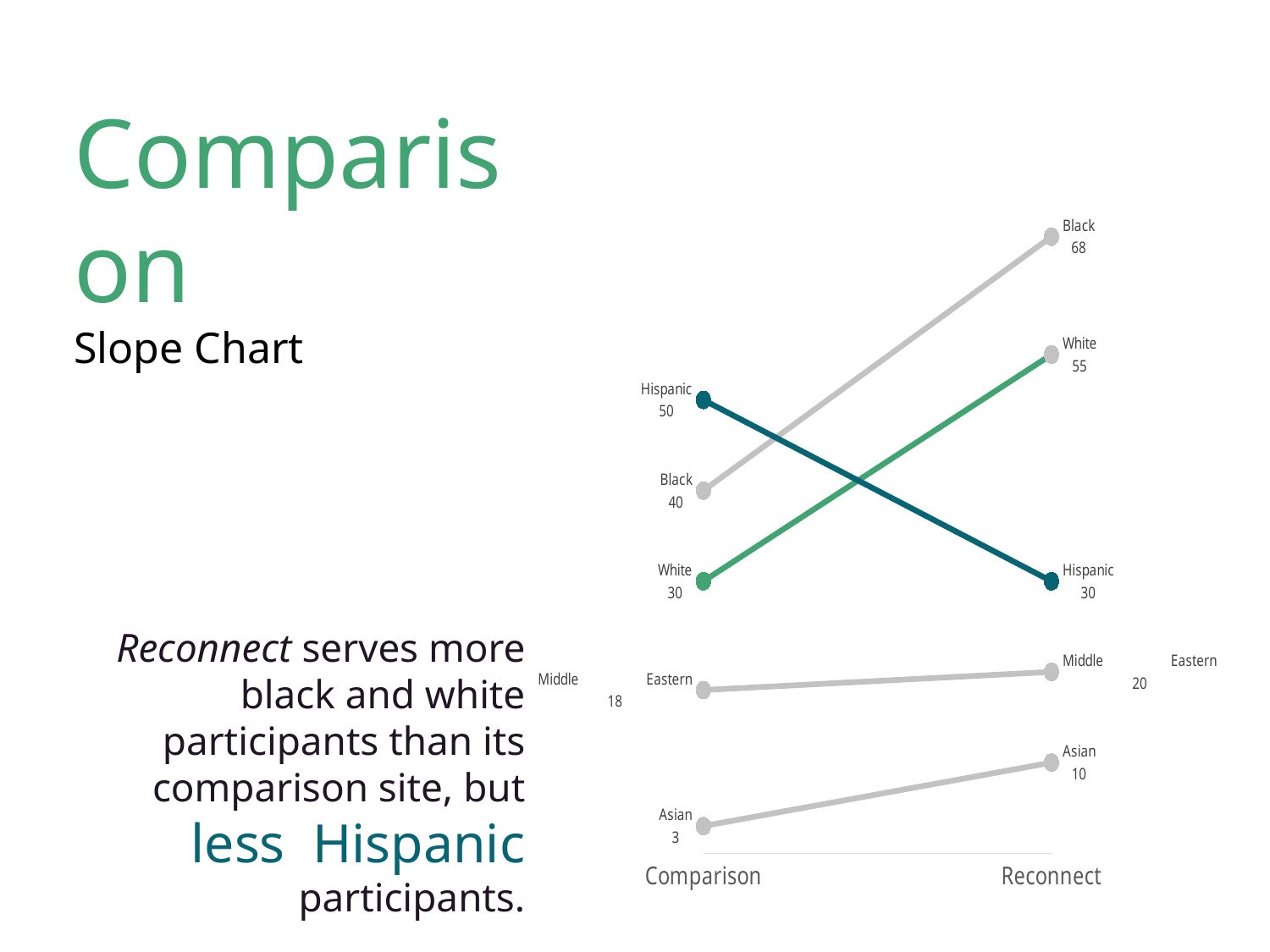
By how much does the Black value increase from Comparison to Reconnect? 28 Which group has the lowest value at the Comparison site? Asian What is the value for Black at the Reconnect site? 68 What is the value for Asian at the Comparison site? 3 What type of chart is shown on the slide? Slope chart What is the difference between the Hispanic values at Comparison and Reconnect? 20 What is the value for Hispanic at the Comparison site? 50 How many groups are plotted on the slope chart? 5 Which is larger: the White value at Reconnect or the Hispanic value at Comparison? White value at Reconnect Does the Hispanic value rise or fall from Comparison to Reconnect? Fall Which group has the highest value at the Reconnect site? Black What is the value for White at the Reconnect site? 55